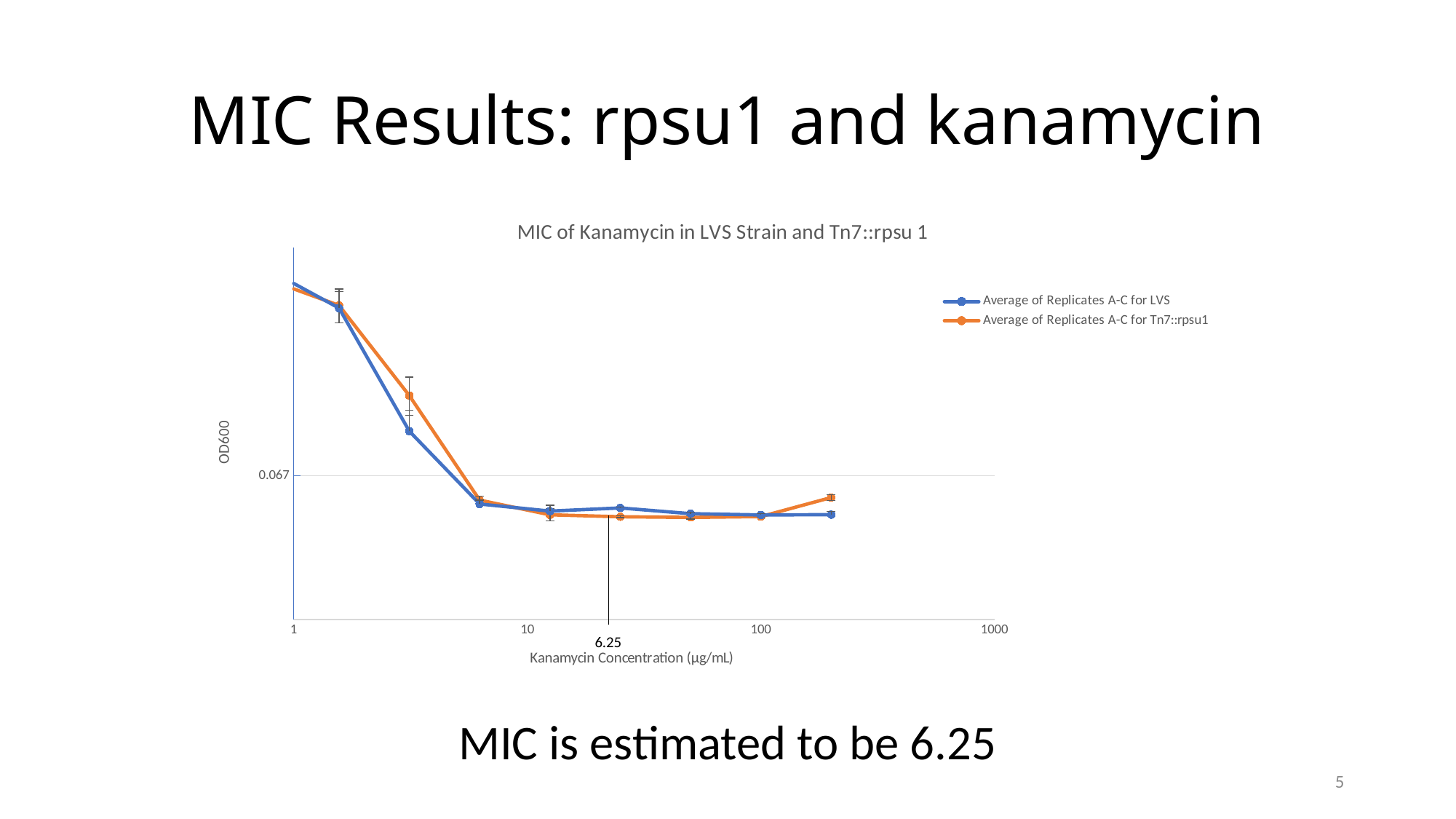
What is the title of the chart? MIC of Kanamycin in LVS Strain and Tn7::rpsu 1 At the highest kanamycin concentration plotted, which series has the larger OD600 value: Average of Replicates A-C for LVS or Average of Replicates A-C for Tn7::rpsu1? Average of Replicates A-C for Tn7::rpsu1 How many series does the legend list? 2 What kanamycin concentration is marked on the x axis as the estimated MIC? 6.25 What is the label of the y axis? OD600 Do the OD600 values rise or fall as kanamycin concentration increases along the x axis? fall Is the value for Average of Replicates A-C for Tn7::rpsu1 at a kanamycin concentration of 10 µg/mL greater or less than 0.067? less Is the value for Average of Replicates A-C for LVS at a kanamycin concentration of 1 µg/mL greater or less than 0.067? greater At a kanamycin concentration of about 3 µg/mL, which series has the larger OD600 value: Average of Replicates A-C for LVS or Average of Replicates A-C for Tn7::rpsu1? Average of Replicates A-C for Tn7::rpsu1 Is the value for Average of Replicates A-C for LVS at a kanamycin concentration of 100 µg/mL greater or less than 0.067? less What kind of chart is shown on the slide? line chart